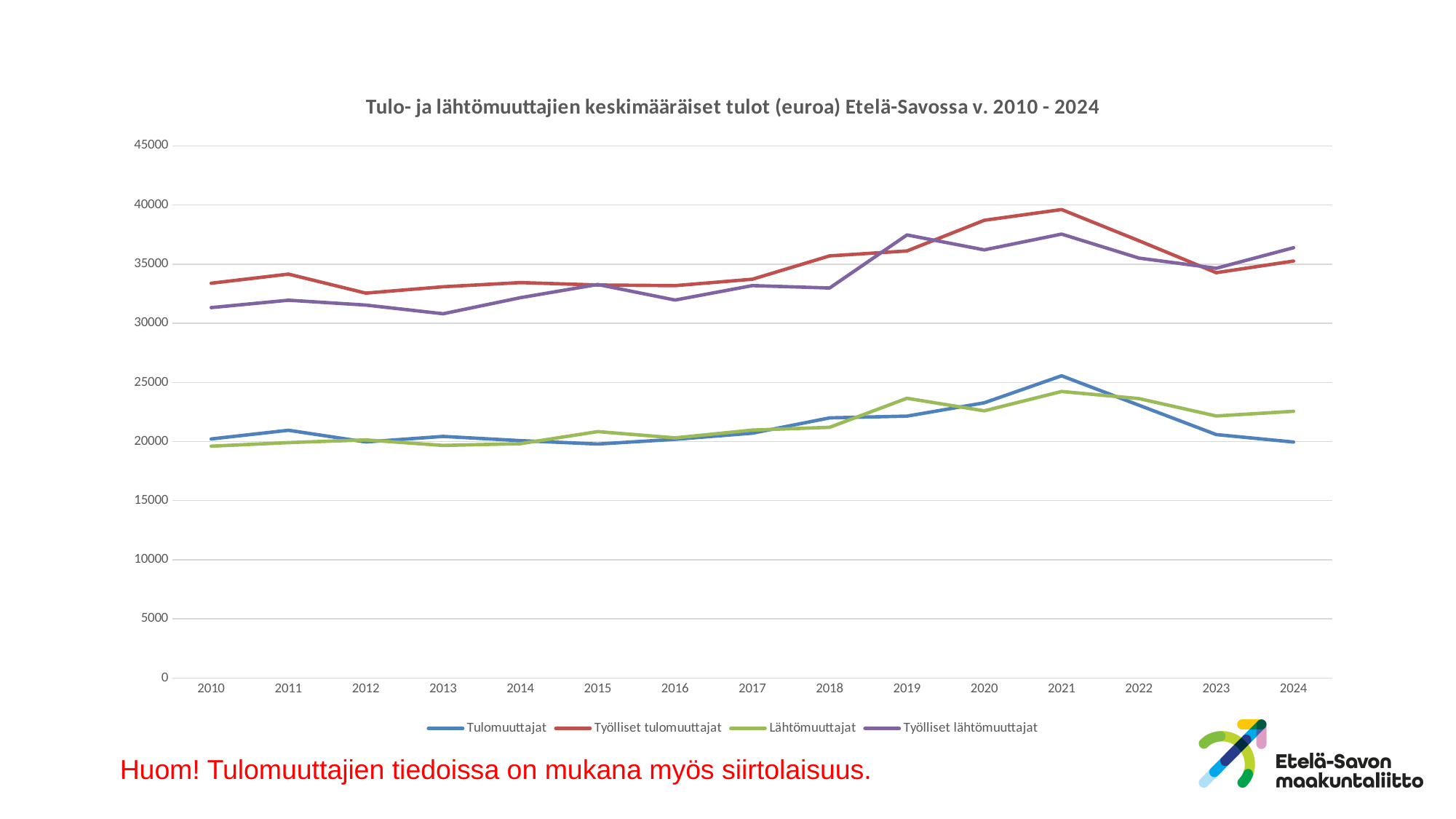
How many series does the legend list? 4 In which year does the Työlliset lähtömuuttajat series reach its lowest value? 2013 In which year does the Työlliset tulomuuttajat series reach its highest value? 2021 In 2023, which series has the higher value: Lähtömuuttajat or Tulomuuttajat? Lähtömuuttajat Is the value for Työlliset tulomuuttajat in 2021 greater or less than 35000? greater Does the Tulomuuttajat series rise or fall from 2021 to 2024? fall How many years are plotted along the x axis? 15 What kind of chart is shown on the slide? line chart In 2019, which series has the higher value: Työlliset lähtömuuttajat or Työlliset tulomuuttajat? Työlliset lähtömuuttajat In which year does the Tulomuuttajat series reach its highest value? 2021 What is the title of the chart? Tulo- ja lähtömuuttajien keskimääräiset tulot (euroa) Etelä-Savossa v. 2010 - 2024 Is the value for Työlliset tulomuuttajat in 2012 greater or less than 35000? less